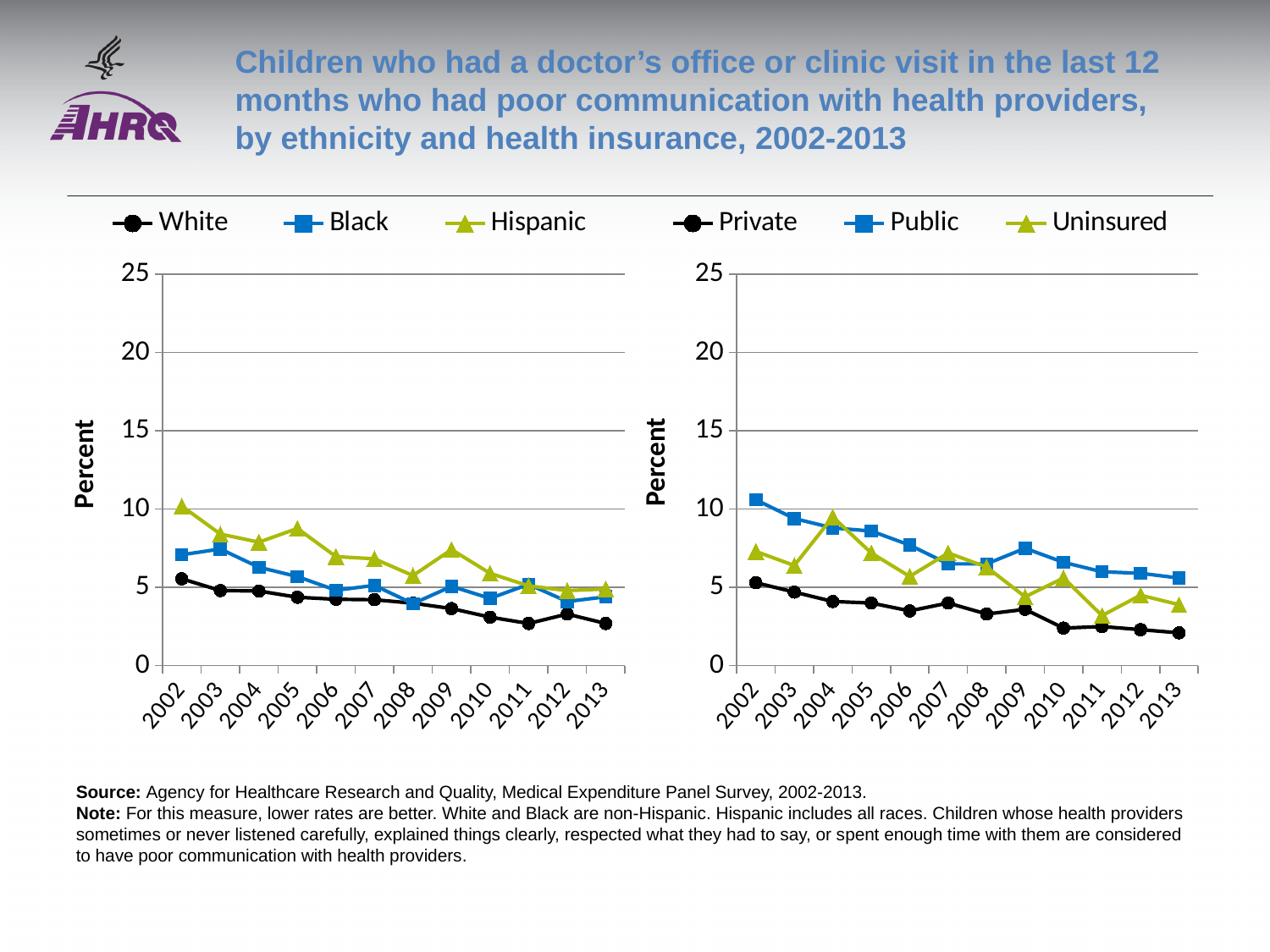
In the left chart, which series has the highest value in 2002? Hispanic How many years are plotted along the x axis of the right chart? 12 What kind of chart is the left chart on the slide? Line chart In the left chart, which series has the lowest value in 2002? White How many series does the legend of the left chart list? 3 In the right chart, which series has the lowest value in 2013? Private How many series does the legend of the right chart list? 3 In the right chart, is the value for Private in 2013 greater or less than 5? less What label is shown on the y axis of the right chart? Percent In the left chart, does the White series generally rise or fall from 2002 to 2013? Fall In the left chart, is the value for Hispanic in 2002 greater or less than 5? greater In the right chart, which series has the highest value in 2002? Public